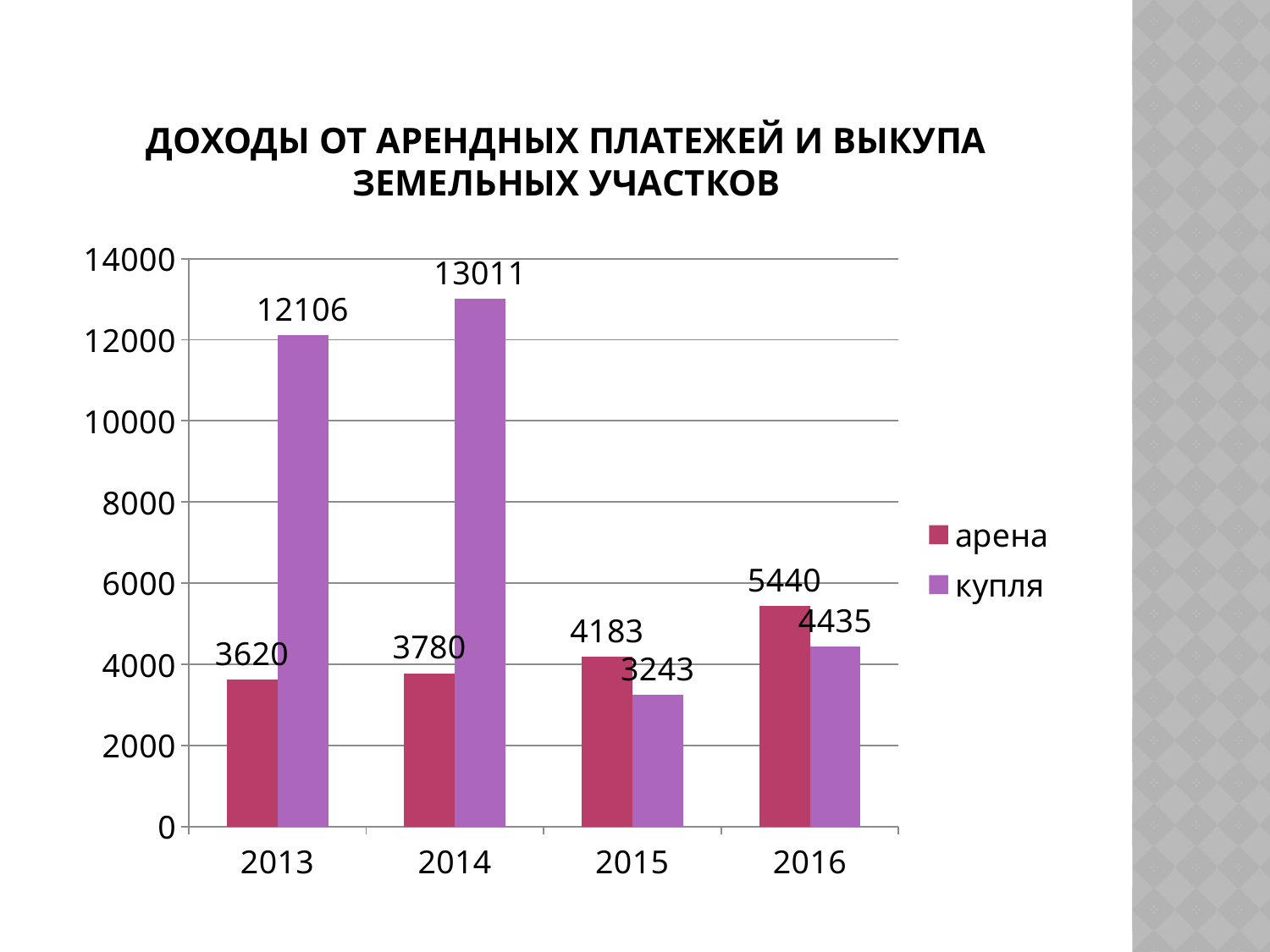
Does the value for арена rise or fall from 2013 to 2016? rise What kind of chart is shown on the slide? bar chart What is the value for арена in 2013? 3620 In which year is the value for арена lowest? 2013 What is the value for купля in 2015? 3243 How many series does the legend list? 2 In which year is the value for купля highest? 2014 How many years are shown on the x axis? 4 Which is larger in 2016, арена or купля? арена What is the difference between купля and арена in 2013? 8486 What is the value for арена in 2016? 5440 What is the value for купля in 2014? 13011